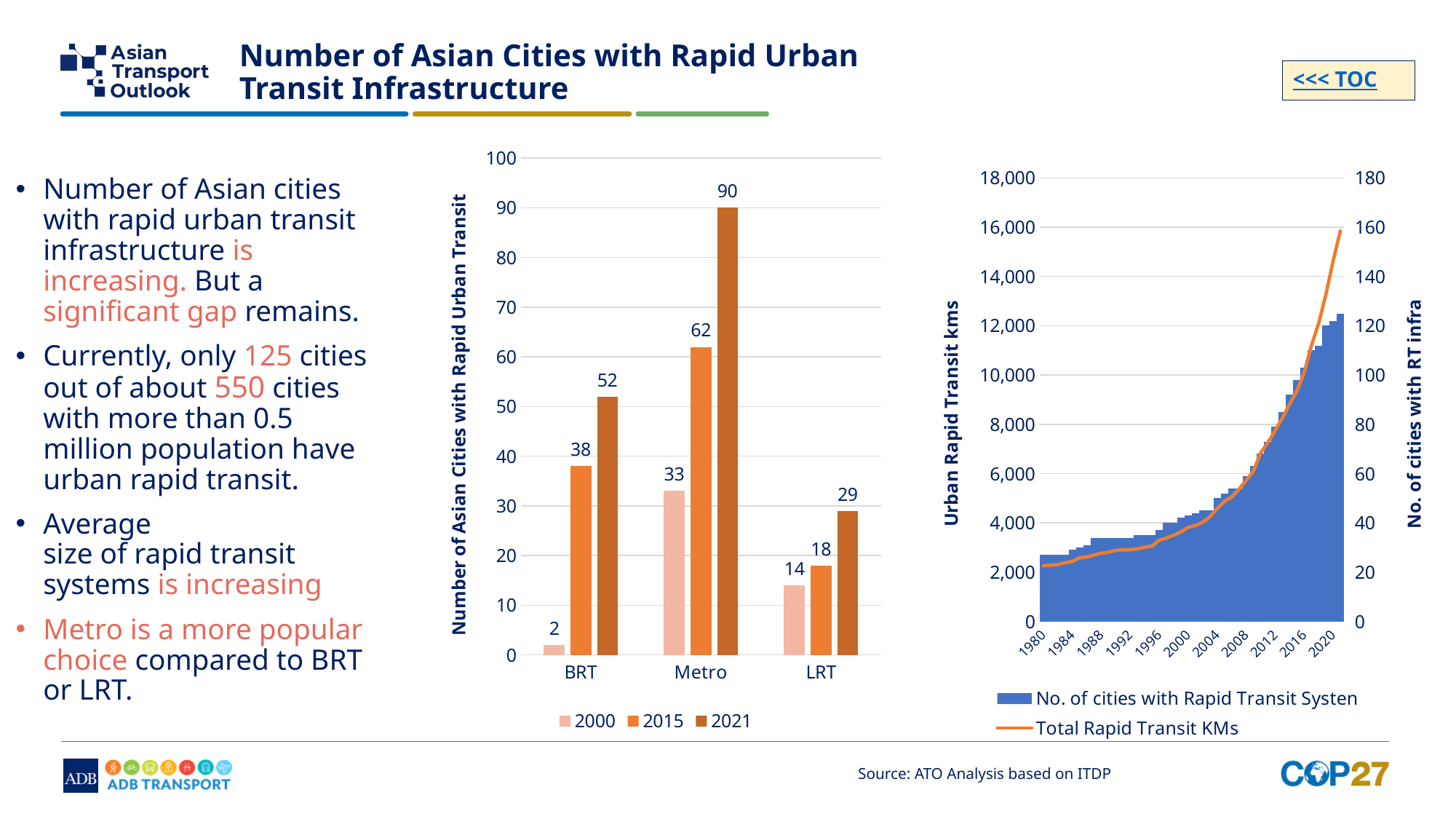
In the right chart, is the value of Total Rapid Transit KMs in 2020 greater or less than 14,000? greater In the right chart, does the number of cities with a Rapid Transit System rise or fall from 1980 to 2020? rise How many categories are shown on the x axis of the left bar chart? 3 In the left bar chart, how many Asian cities had Metro in 2021? 90 In the left bar chart, what is the difference between the Metro values for 2021 and 2015? 28 How many series does the legend of the left bar chart list? 3 In the left bar chart, which is larger: BRT in 2021 or LRT in 2021? BRT in 2021 In the left bar chart, which category has the highest value for 2021? Metro What is the label of the left vertical axis of the right chart? Urban Rapid Transit kms In the left bar chart, what is the value for LRT in 2015? 18 In the left bar chart, which category has the lowest value for 2000? BRT In the left bar chart, what is the value for BRT in 2000? 2